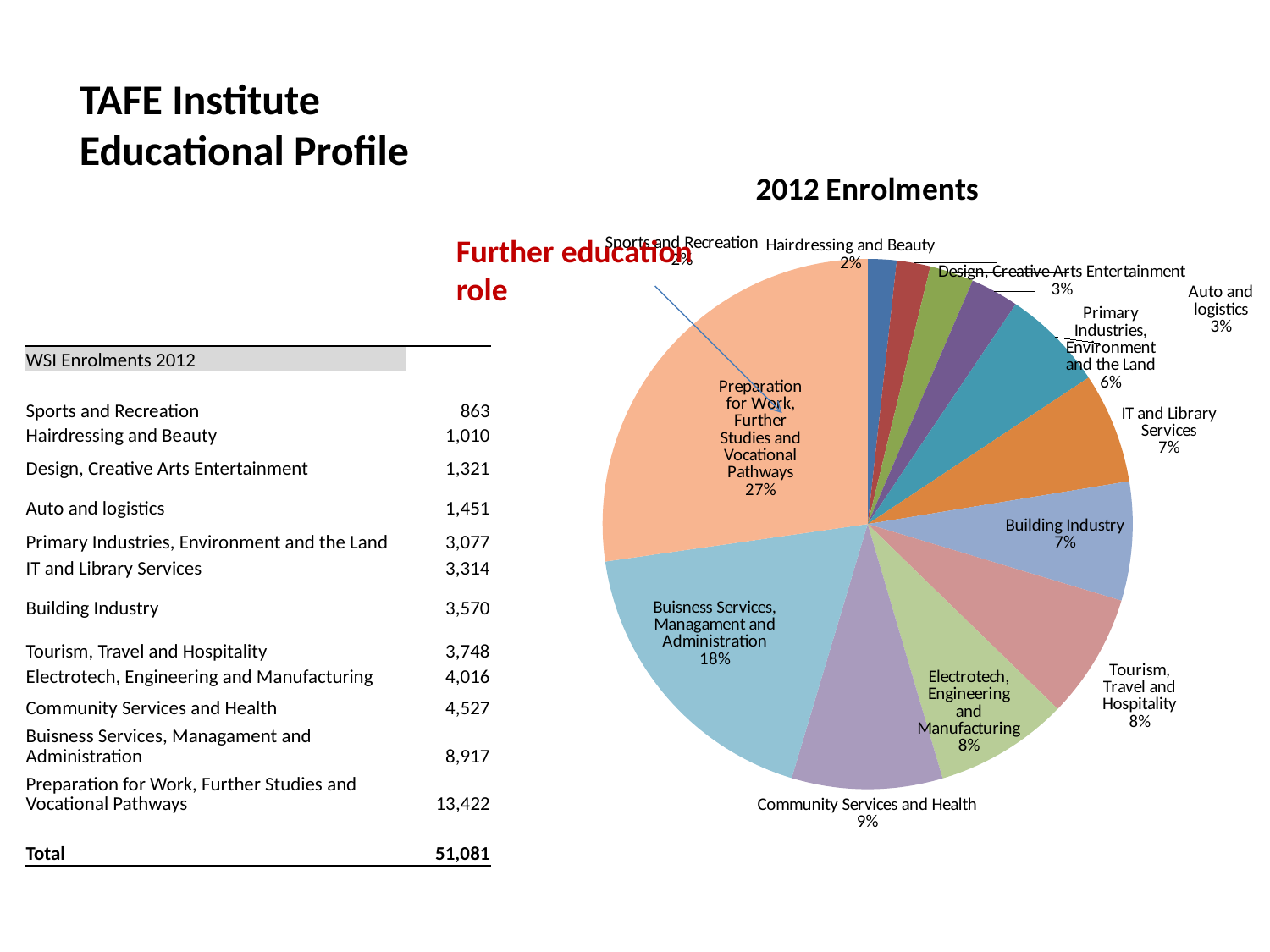
Which category has the largest slice of the pie? Preparation for Work, Further Studies and Vocational Pathways What share of the pie does Preparation for Work, Further Studies and Vocational Pathways represent? 27% How many slices does the pie chart have? 12 What percentage is shown for Community Services and Health? 9% What percentage is shown for Building Industry? 7% What type of chart is shown on the slide? pie chart Which slice is larger, Community Services and Health or IT and Library Services? Community Services and Health What percentage is shown for Auto and logistics? 3% What is the title of the chart? 2012 Enrolments What percentage is shown for Primary Industries, Environment and the Land? 6% What share of the pie does Buisness Services, Managament and Administration represent? 18% What is the difference in percentage points between Preparation for Work, Further Studies and Vocational Pathways and Buisness Services, Managament and Administration? 9